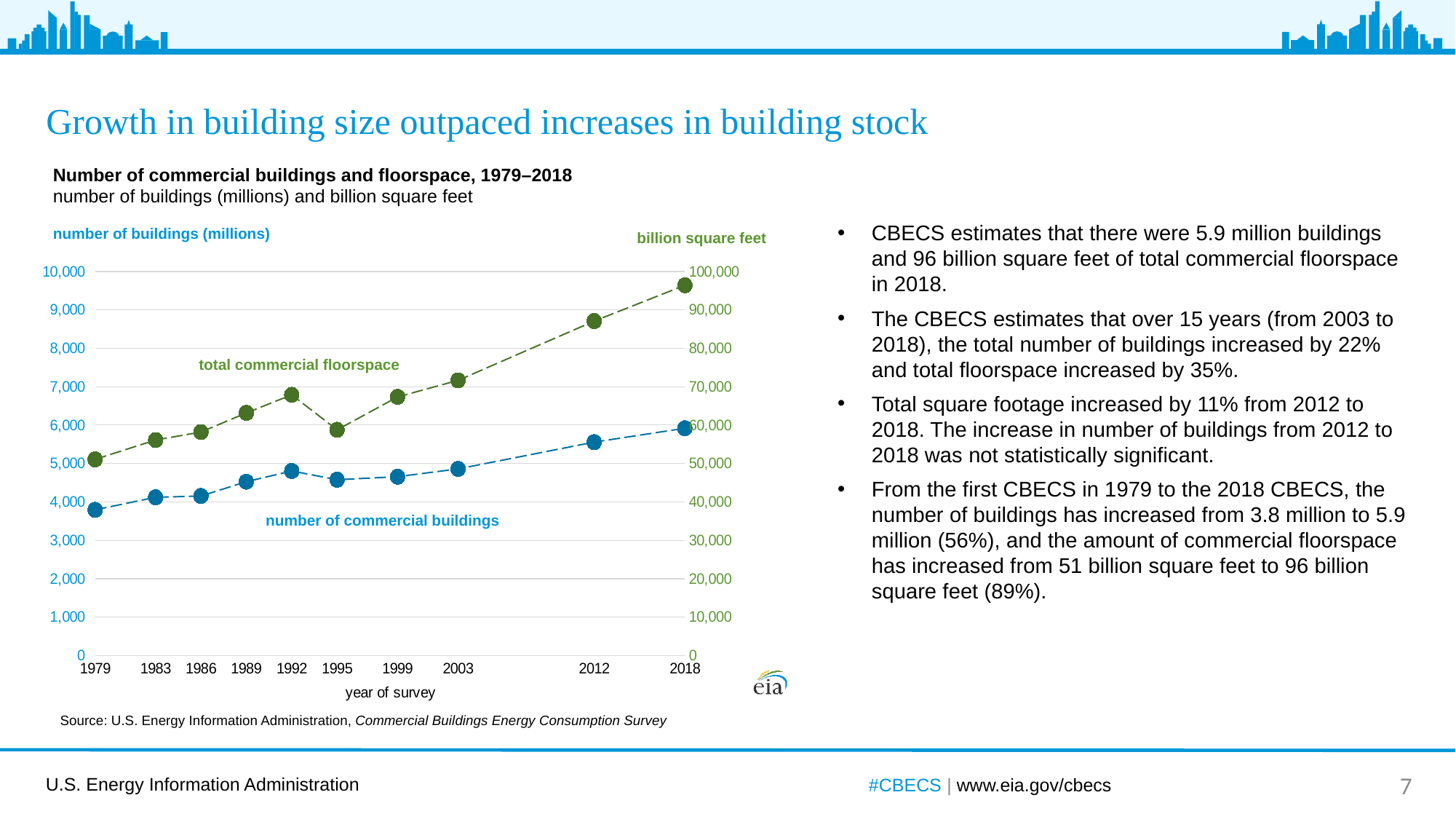
In which survey year is total commercial floorspace highest? 2018 Is the number of commercial buildings in 1979 greater or less than 4,000? less How many data series are plotted on the chart? 2 How many survey years are plotted along the x axis? 10 What is the title of the x axis? year of survey Is total commercial floorspace in 2018 greater or less than 90,000? greater What kind of chart is shown on the slide? line chart Overall, does the number of commercial buildings rise or fall from 1979 to 2018? rise Is the number of commercial buildings in 2012 greater or less than 5,000? greater Which year has higher total commercial floorspace, 1992 or 1995? 1992 In which survey year is the number of commercial buildings lowest? 1979